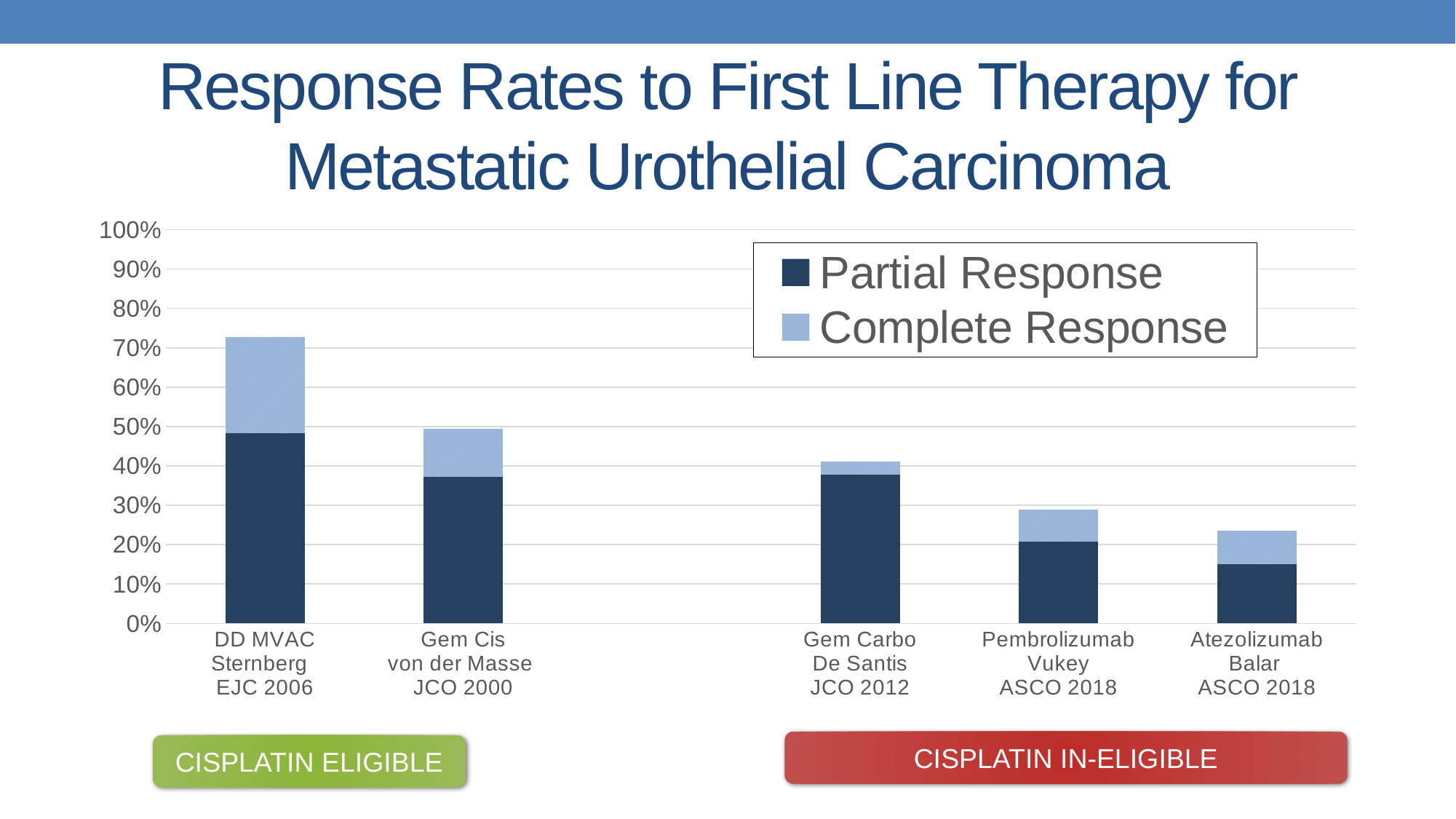
Do the total response rates generally rise or fall moving from left to right across the x axis? fall How many treatment categories are plotted on the x axis? 5 Is the Partial Response value for Atezolizumab greater or less than 20%? less Is the total response rate for DD MVAC greater or less than 70%? greater Is the total response rate for Atezolizumab greater or less than 30%? less How many series does the legend list? 2 Which two treatments are grouped under the 'CISPLATIN ELIGIBLE' label? DD MVAC and Gem Cis Which treatment has the lowest total response rate (shortest stacked bar)? Atezolizumab (Balar ASCO 2018) Which has a larger total response rate, Gem Cis or Gem Carbo? Gem Cis Which treatment has the highest total response rate (tallest stacked bar)? DD MVAC (Sternberg EJC 2006) What kind of chart is shown on the slide? Stacked bar chart